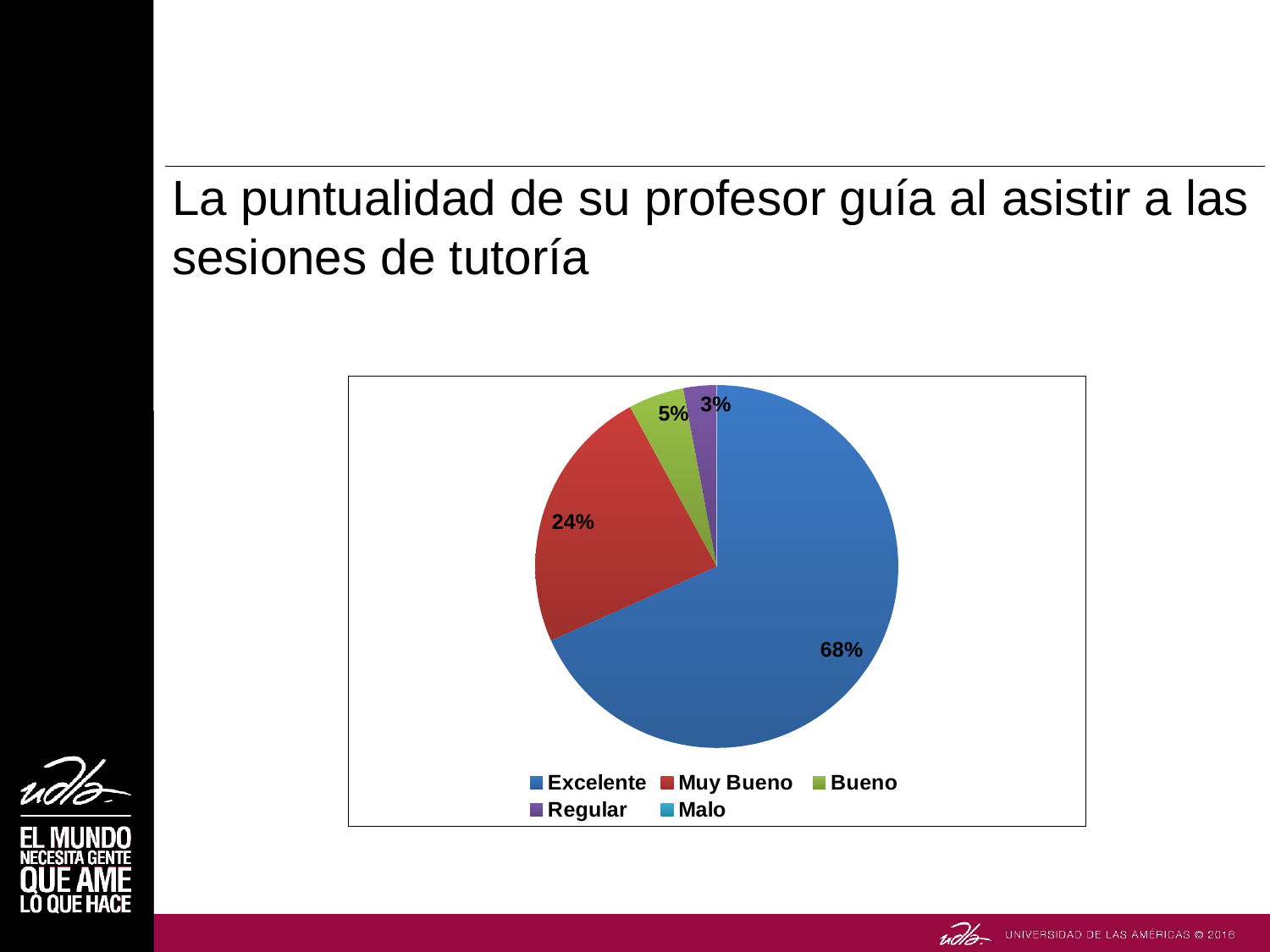
What percentage of the pie chart corresponds to Regular? 3% What kind of chart is shown on the slide? Pie chart What is the difference in percentage points between the Excelente slice and the Muy Bueno slice? 44 What percentage of the pie chart corresponds to Muy Bueno? 24% What percentage of the pie chart corresponds to Excelente? 68% Which slice is larger, Bueno or Regular? Bueno What percentage of the pie chart corresponds to Bueno? 5% Which category has the largest slice of the pie chart? Excelente What is the combined share of the Excelente and Muy Bueno slices? 92% What colour is the Excelente slice in the pie chart? Blue What is the title of the slide containing the pie chart? La puntualidad de su profesor guía al asistir a las sesiones de tutoría How many entries does the legend of the pie chart list? 5